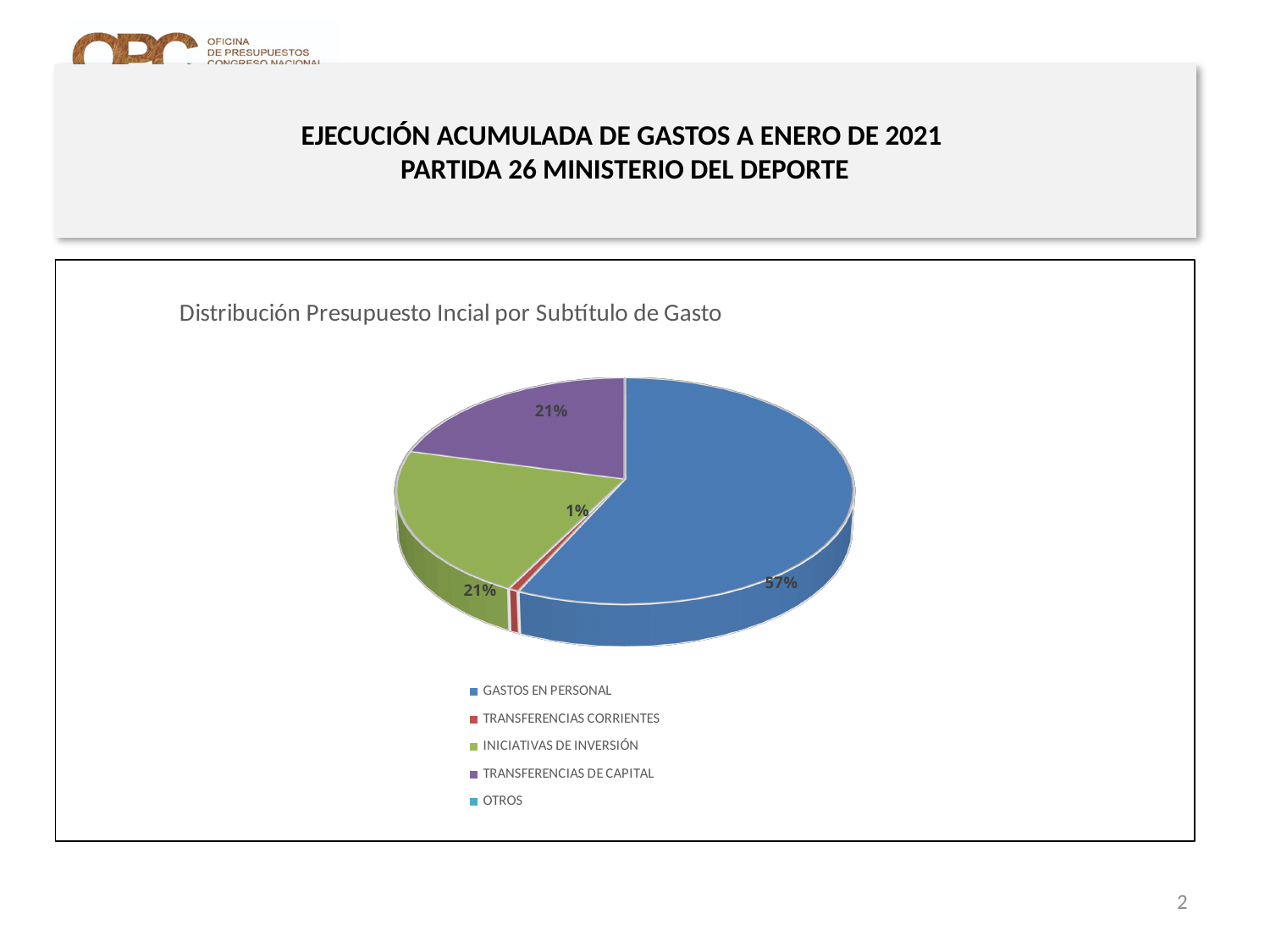
What is the difference in percentage points between the GASTOS EN PERSONAL slice and the TRANSFERENCIAS DE CAPITAL slice? 36 percentage points What share of the pie does TRANSFERENCIAS DE CAPITAL represent? 21% What is the title of the chart? Distribución Presupuesto Incial por Subtítulo de Gasto What kind of chart is shown on the slide? Pie chart What share of the pie does INICIATIVAS DE INVERSIÓN represent? 21% Which is larger, the slice for GASTOS EN PERSONAL or the slice for INICIATIVAS DE INVERSIÓN? GASTOS EN PERSONAL Which category has the largest slice of the pie? GASTOS EN PERSONAL What share of the pie does GASTOS EN PERSONAL represent? 57% Among the slices with a printed percentage, which category has the smallest slice? TRANSFERENCIAS CORRIENTES What colour is the GASTOS EN PERSONAL slice? Blue How many entries does the chart legend list? 5